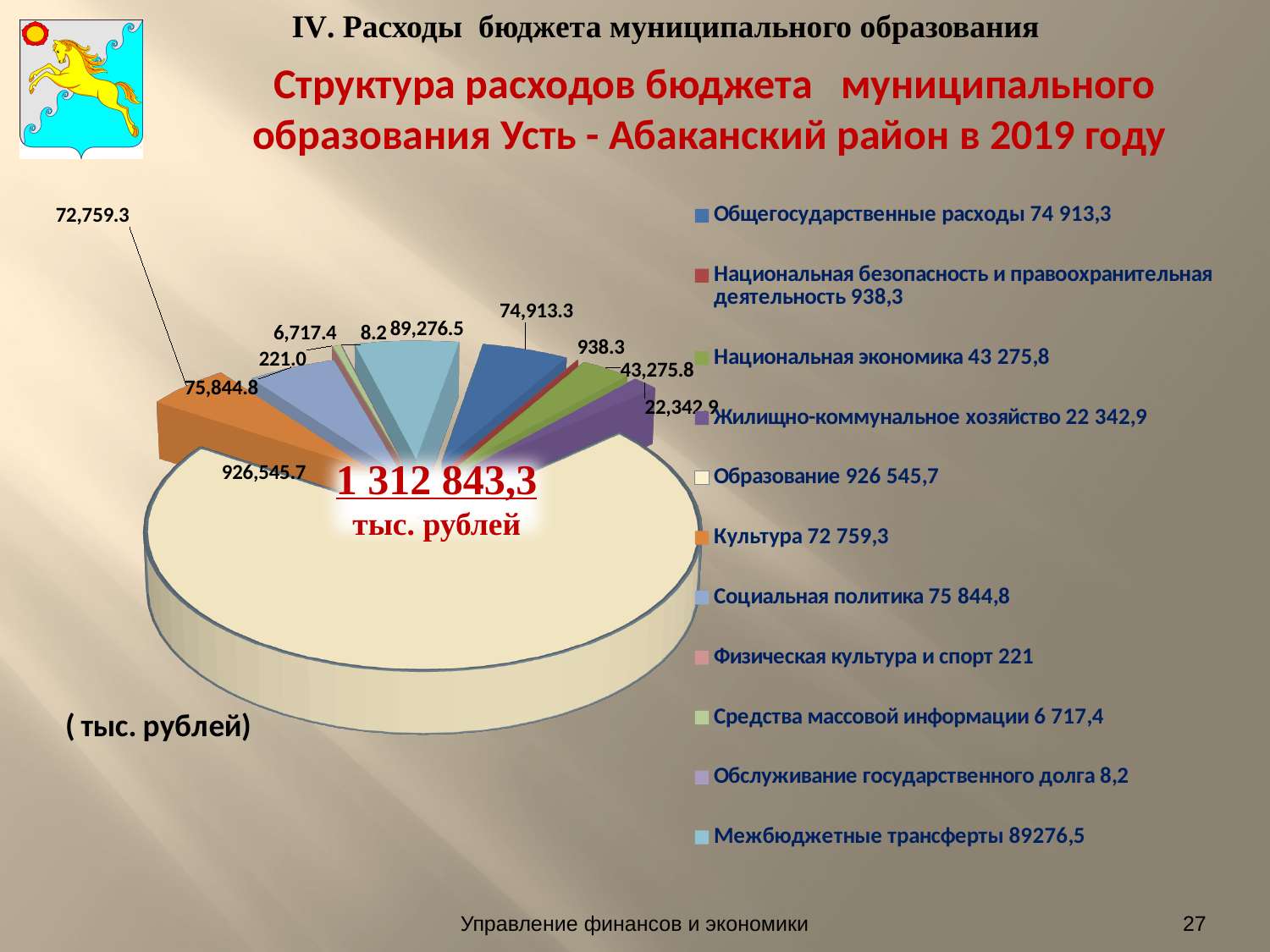
How many categories does the pie chart have? 11 What is the difference between Социальная политика (75,844.8) and Культура (72,759.3)? 3,085.5 In what units are the values of the chart given? тыс. рублей What is the value shown for Обслуживание государственного долга? 8.2 Which is larger: Социальная политика or Культура? Социальная политика What is the value shown for Культура? 72,759.3 What is the value shown for Образование? 926,545.7 What is the value shown for Межбюджетные трансферты? 89,276.5 What kind of chart is shown on the slide? pie chart Which category has the smallest value in the pie chart? Обслуживание государственного долга What total amount is printed in the centre of the pie chart? 1 312 843,3 тыс. рублей Which category has the largest slice of the pie? Образование